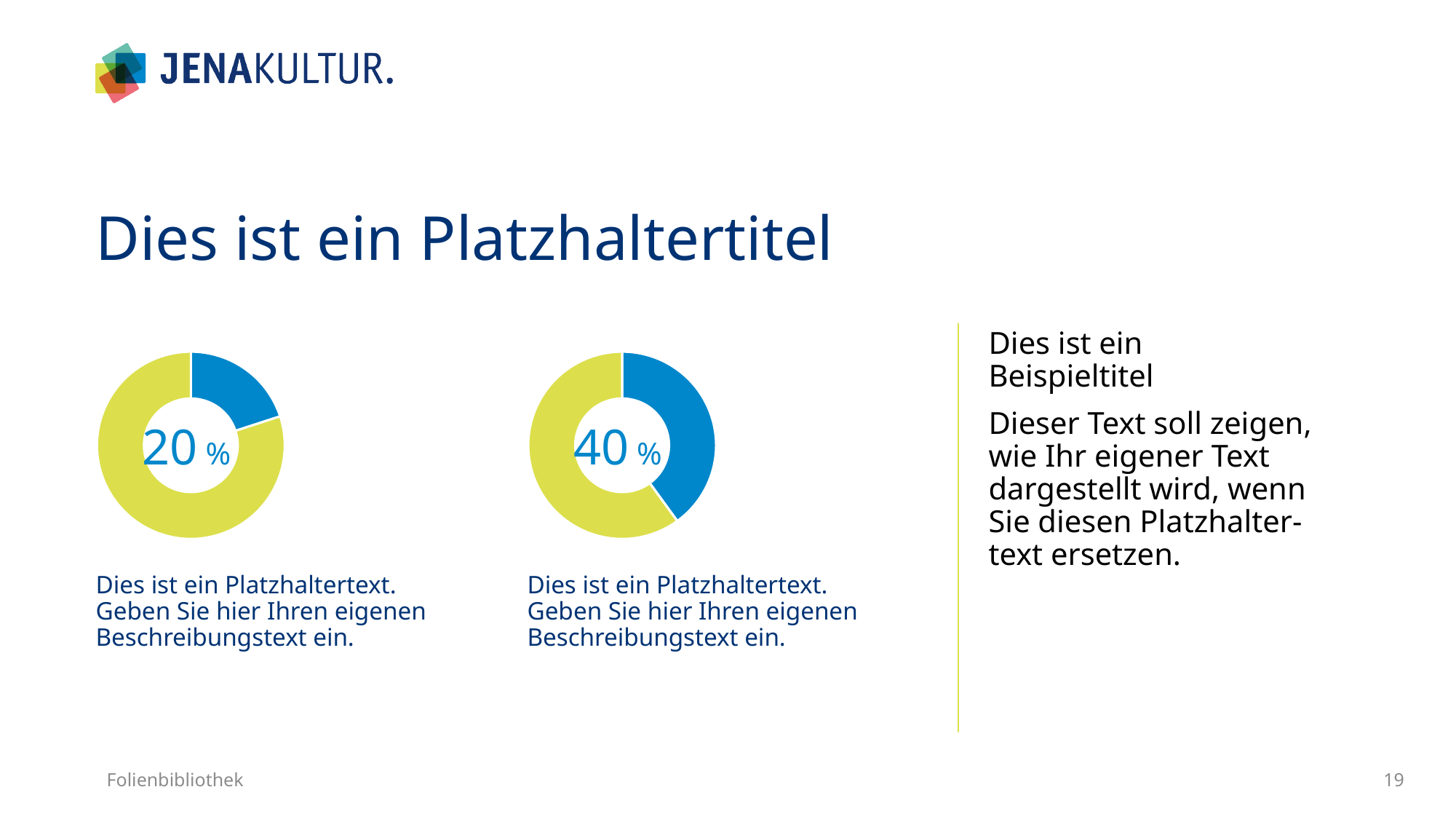
What two colours are used for the slices in the donut charts? Blue and yellow-green Which donut chart shows the larger percentage, the left one or the right one? The right one In the left donut chart, what share of the ring does the blue slice represent? 20 % How many slices does the left donut chart have? 2 In the right donut chart, what share of the ring does the blue slice represent? 40 % What percentage is printed in the centre of the left donut chart? 20 % In the left donut chart, is the blue slice larger or smaller than the yellow-green slice? Smaller How many donut charts are shown on the slide? 2 What kind of chart is shown on the left of the slide? Donut chart What percentage is printed in the centre of the right donut chart? 40 % What is the difference between the percentage shown in the right donut chart and the one in the left donut chart? 20 percentage points How many slices does the right donut chart have? 2